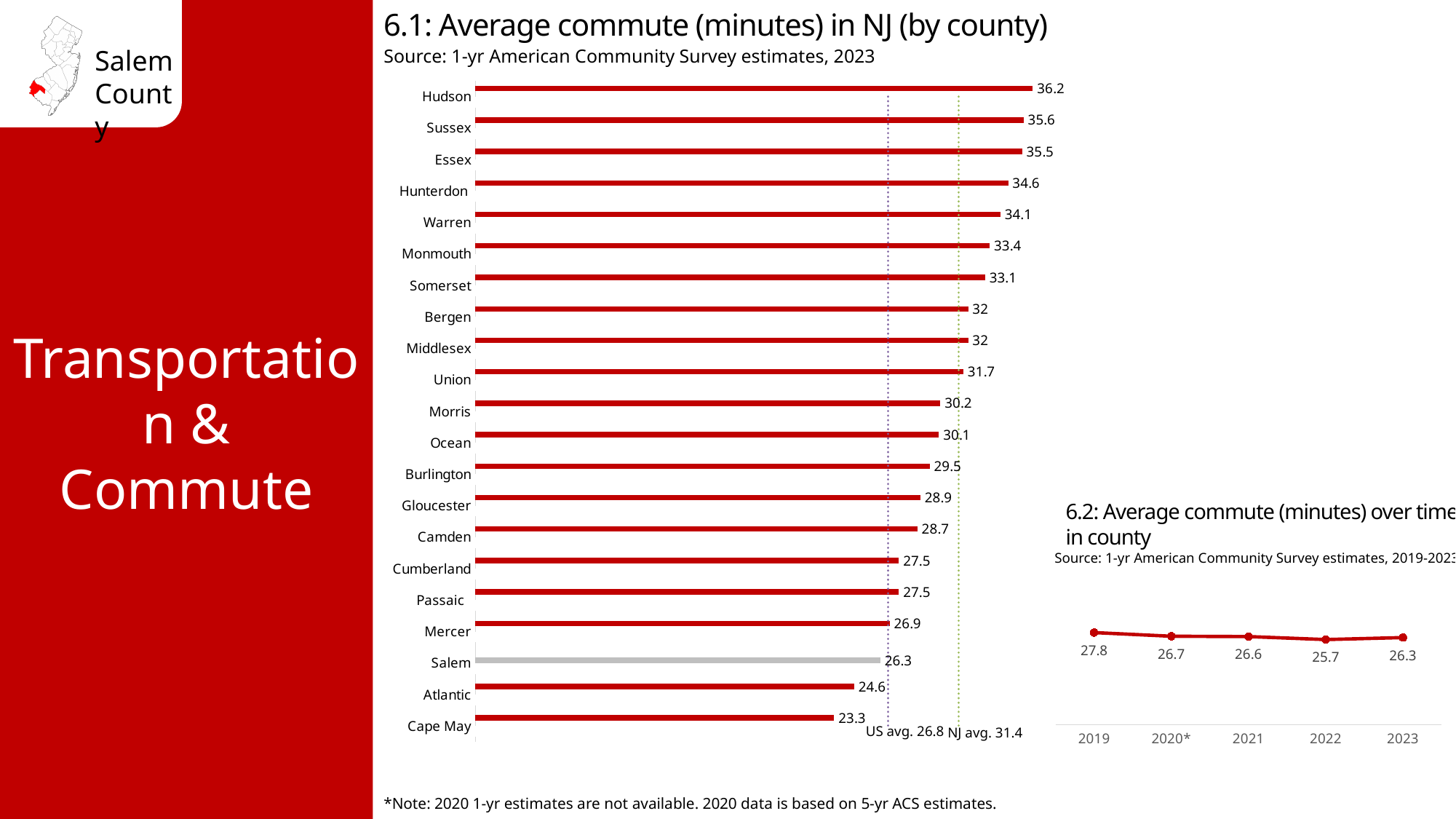
In chart 6.1 (Average commute in NJ by county), how many counties are shown? 21 In chart 6.1 (Average commute in NJ by county), which county has the highest average commute? Hudson What kind of chart is chart 6.1 (Average commute in NJ by county)? Bar chart In chart 6.1, what is the NJ average commute shown by the dotted reference line? 31.4 In chart 6.1 (Average commute in NJ by county), what is the average commute for Salem? 26.3 In chart 6.2 (Average commute over time in county), what is the difference between the 2019 and 2023 values? 1.5 In chart 6.1 (Average commute in NJ by county), what is the difference between Hudson's and Cape May's average commute? 12.9 In chart 6.2 (Average commute over time in county), which year has the highest value? 2019 In chart 6.1 (Average commute in NJ by county), which county has the lowest average commute? Cape May In chart 6.1 (Average commute in NJ by county), what is the average commute for Gloucester? 28.9 In chart 6.1 (Average commute in NJ by county), which has a longer average commute, Mercer or Atlantic? Mercer In chart 6.2 (Average commute over time in county), what is the value for 2022? 25.7